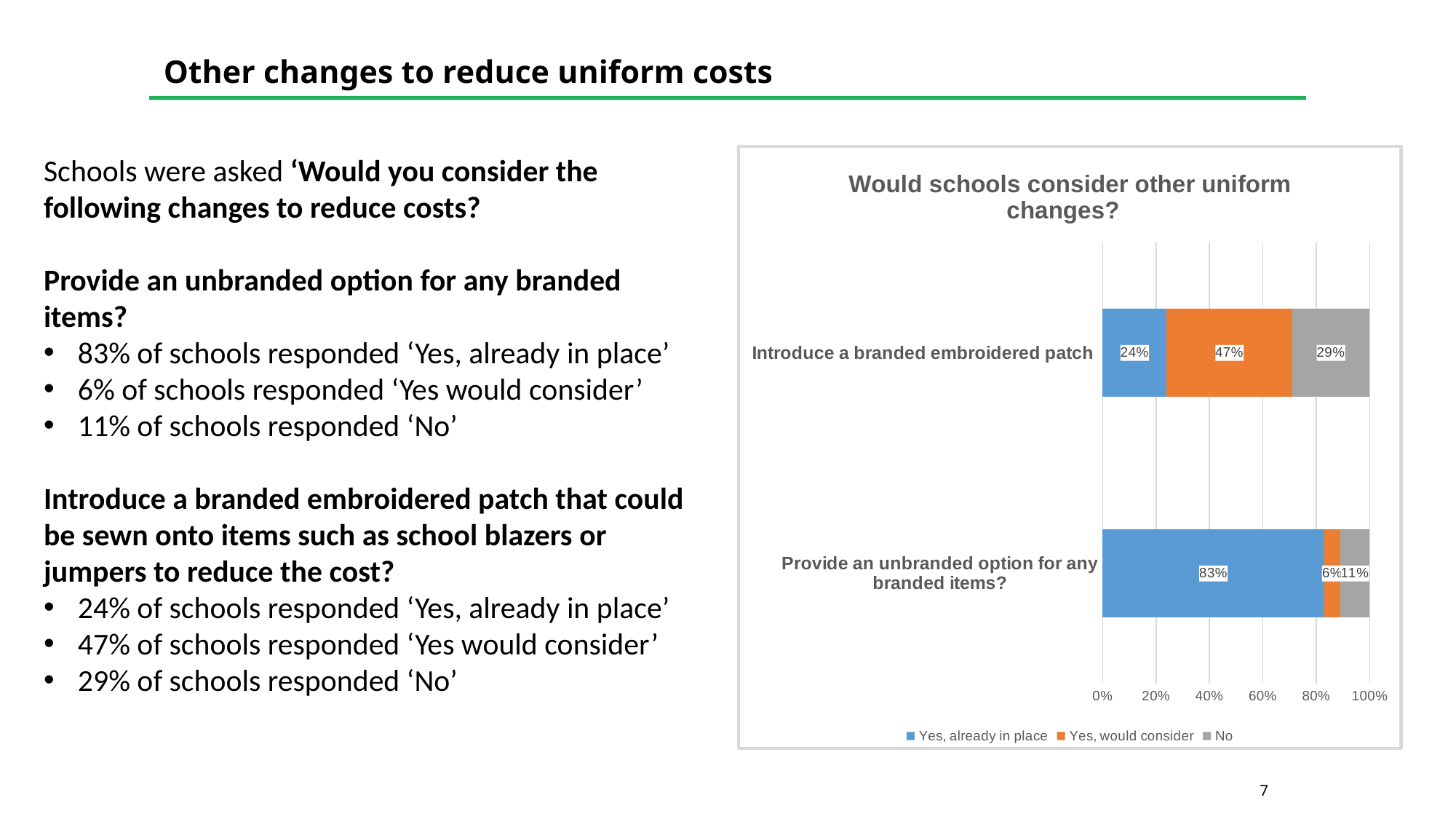
What percentage of schools responded 'Yes, already in place' for 'Introduce a branded embroidered patch'? 24% How many series does the legend list? 3 What percentage of schools responded 'Yes, would consider' for 'Introduce a branded embroidered patch'? 47% What kind of chart is shown? Stacked bar chart What percentage of schools responded 'Yes, already in place' for 'Provide an unbranded option for any branded items?'? 83% Which category has the higher 'Yes, already in place' value? Provide an unbranded option for any branded items? What is the difference between the 'Yes, would consider' values for the two categories? 41% Which category has the lower 'No' value? Provide an unbranded option for any branded items? How many categories are shown on the chart? 2 What is the title of the chart? Would schools consider other uniform changes? Is the 'Yes, would consider' value larger for 'Introduce a branded embroidered patch' or for 'Provide an unbranded option for any branded items?'? Introduce a branded embroidered patch What percentage of schools responded 'No' for 'Provide an unbranded option for any branded items?'? 11%